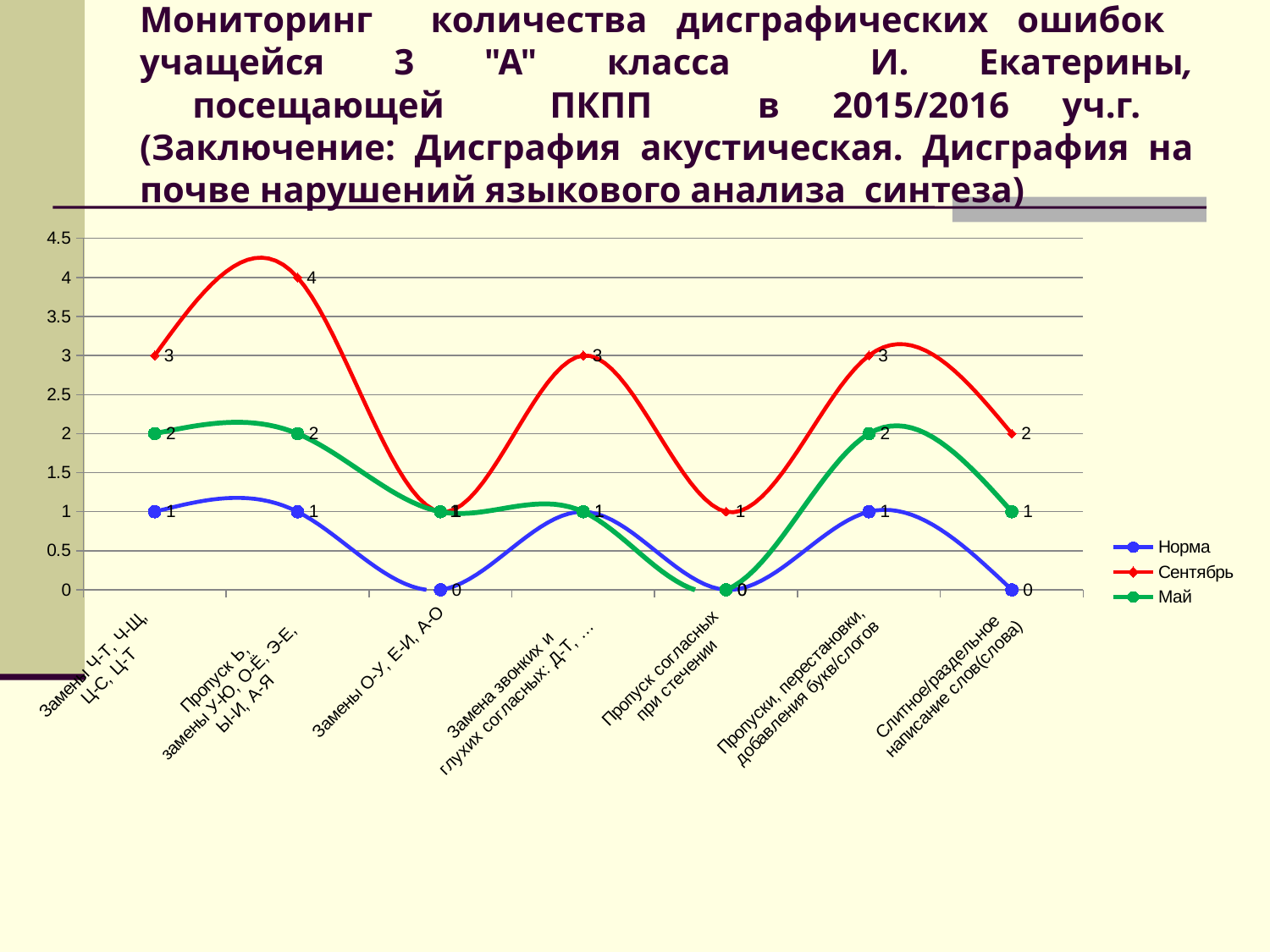
For which category is the Сентябрь value highest? Пропуск Ь, замены У-Ю, О-Ё, Э-Е, Ы-И, А-Я What is the difference between the Сентябрь and Май values for the category "Замена звонких и глухих согласных: Д-Т, ..."? 2 What is the value of Сентябрь for the category "Слитное/раздельное написание слов(слова)"? 2 What kind of chart is shown on the slide? line chart What is the value of Норма for the category "Пропуск согласных при стечении"? 0 What is the value of Май for the category "Замены Ч-Т, Ч-Щ, Ц-С, Ц-Т"? 2 Is the Сентябрь value for "Пропуск Ь, замены У-Ю, О-Ё, Э-Е, Ы-И, А-Я" greater or less than 3.5? greater Which is larger for the category "Пропуски, перестановки, добавления букв/слогов": the Сентябрь value or the Май value? Сентябрь How many series does the legend list? 3 How many categories are plotted along the x axis? 7 What is the value of Сентябрь for the category "Пропуск Ь, замены У-Ю, О-Ё, Э-Е, Ы-И, А-Я"? 4 Which series is drawn in red? Сентябрь